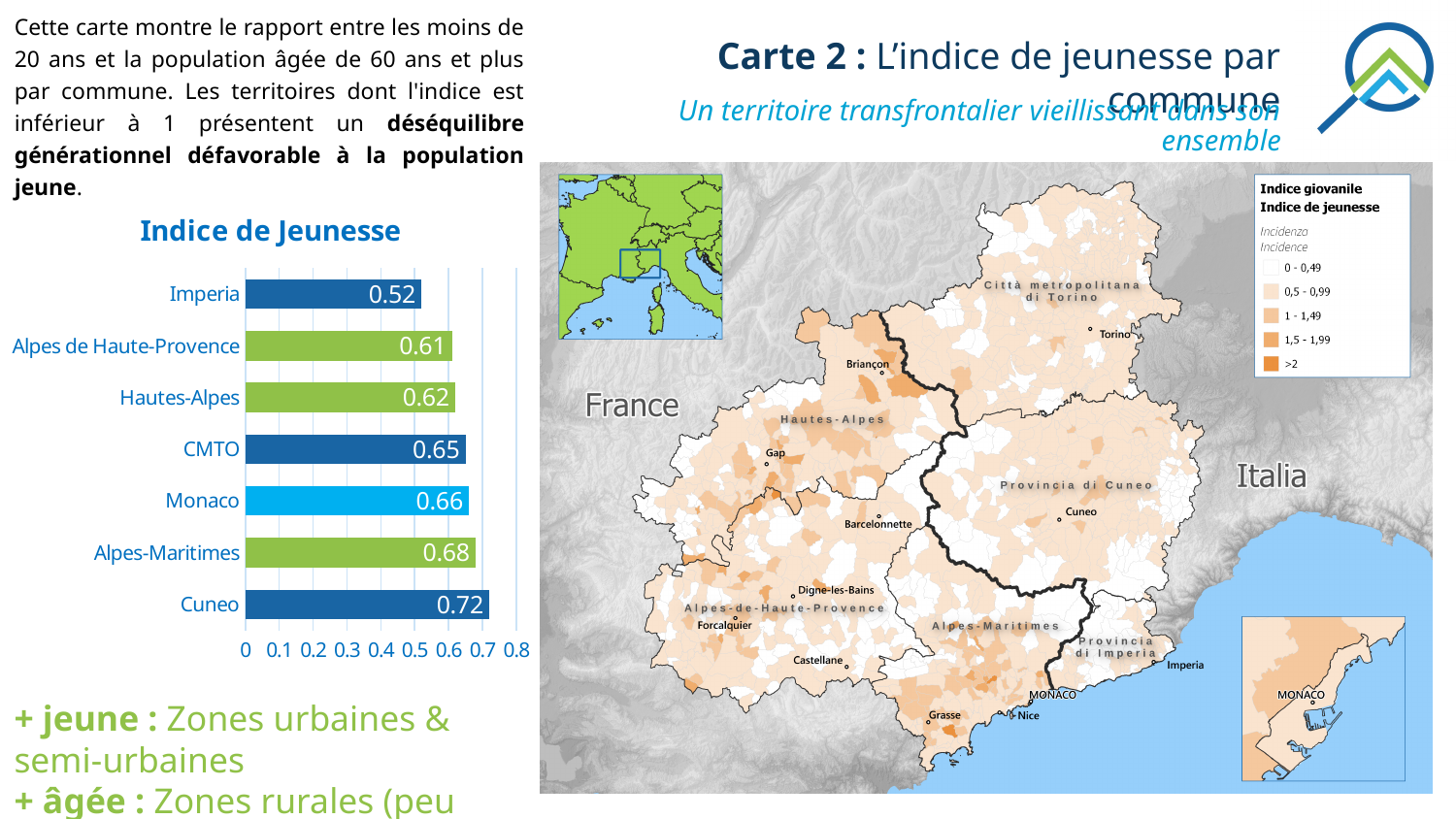
In the 'Indice de Jeunesse' chart, which category has the lowest value? Imperia What kind of chart is the 'Indice de Jeunesse' chart? Bar chart How many categories are shown in the 'Indice de Jeunesse' chart? 7 In the 'Indice de Jeunesse' chart, which category has the highest value? Cuneo In the 'Indice de Jeunesse' chart, which is larger, the value for Alpes-Maritimes or the value for CMTO? Alpes-Maritimes In the 'Indice de Jeunesse' chart, what is the value for Hautes-Alpes? 0.62 What is the title of the bar chart on the left of the slide? Indice de Jeunesse In the 'Indice de Jeunesse' chart, what is the difference between the values for Cuneo and Imperia? 0.20 In the 'Indice de Jeunesse' chart, what is the value for Imperia? 0.52 In the 'Indice de Jeunesse' chart, is the value for Alpes de Haute-Provence greater or less than 0.7? less In the 'Indice de Jeunesse' chart, what is the value for Cuneo? 0.72 In the 'Indice de Jeunesse' chart, what is the value for Monaco? 0.66